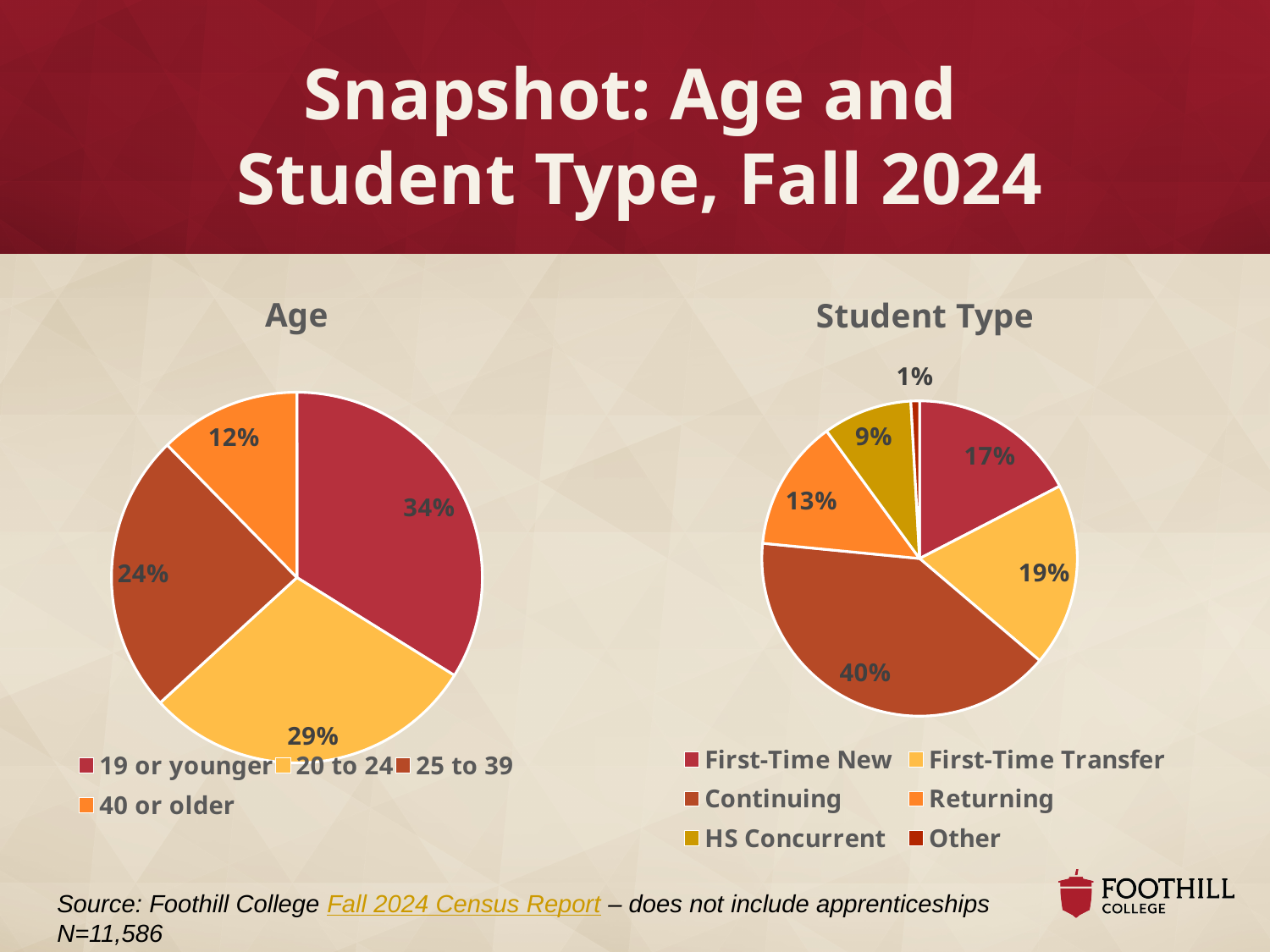
In the Age chart, what share of students are 19 or younger? 34% In the Age chart, what percentage of students are 40 or older? 12% In the Student Type chart, what percentage of students are HS Concurrent? 9% In the Student Type chart, which is larger: First-Time New or First-Time Transfer? First-Time Transfer In the Student Type chart, which student type has the smallest share? Other In the Student Type chart, how many student types does the legend list? 6 In the Student Type chart, what share of students are Continuing? 40% In the Age chart, which age group has the smallest share? 40 or older In the Age chart, which age group has the largest share? 19 or younger What type of chart is used for the Student Type data? Pie chart In the Age chart, how many age categories are shown? 4 In the Age chart, what is the difference between the shares for 20 to 24 and 25 to 39? 5%